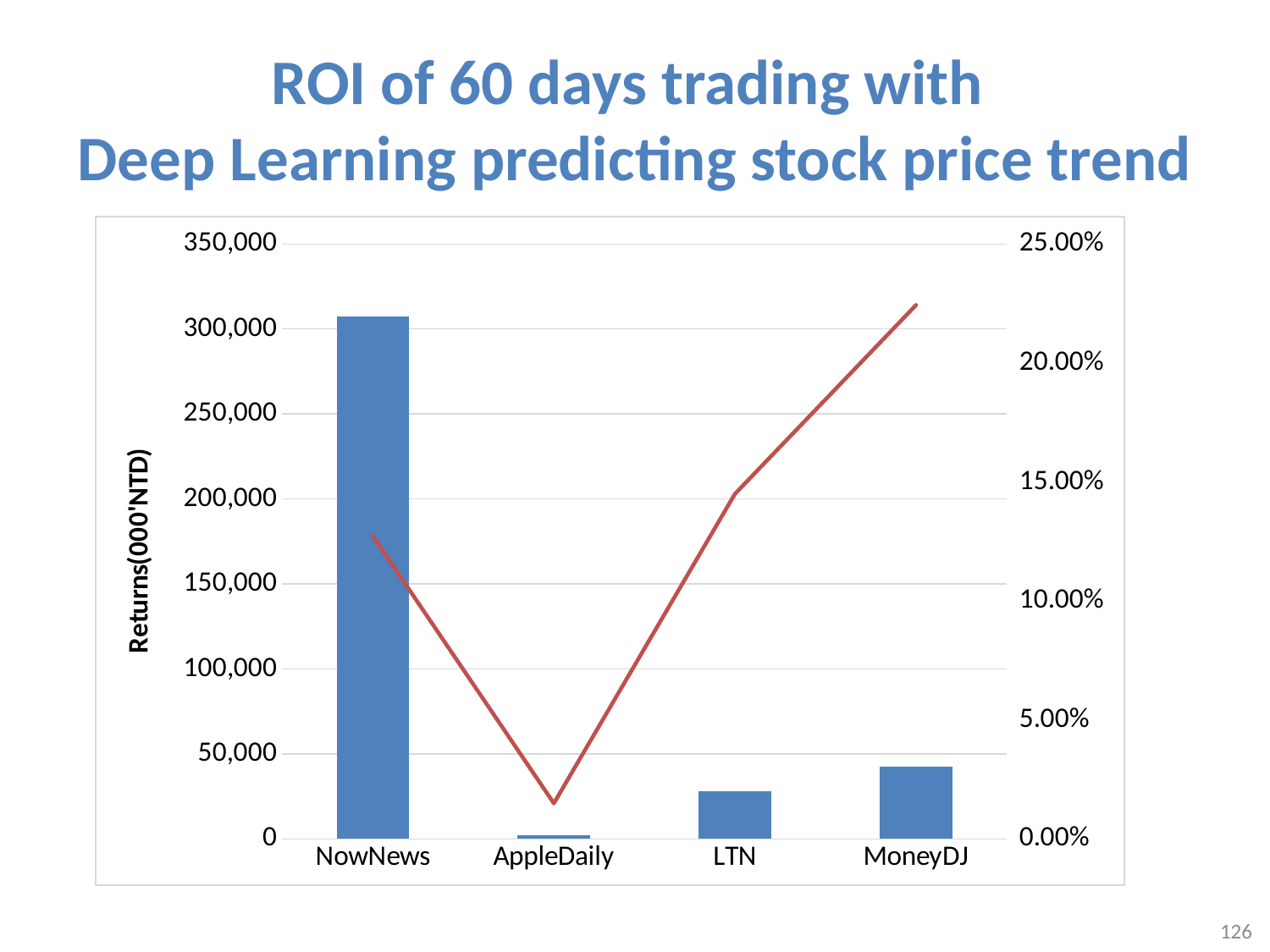
Is the bar value for MoneyDJ greater or less than 50,000? less Is the red line value for MoneyDJ greater or less than 20.00%? greater How many categories are shown on the x axis? 4 Which has the larger bar, LTN or MoneyDJ? MoneyDJ Is the bar value for LTN greater or less than 50,000? less Which category has the shortest bar? AppleDaily At which category does the red line reach its highest point? MoneyDJ What is the label of the left vertical axis? Returns(000'NTD) What is the title of the chart on the slide? ROI of 60 days trading with Deep Learning predicting stock price trend At which category does the red line reach its lowest point? AppleDaily Which category has the tallest bar? NowNews